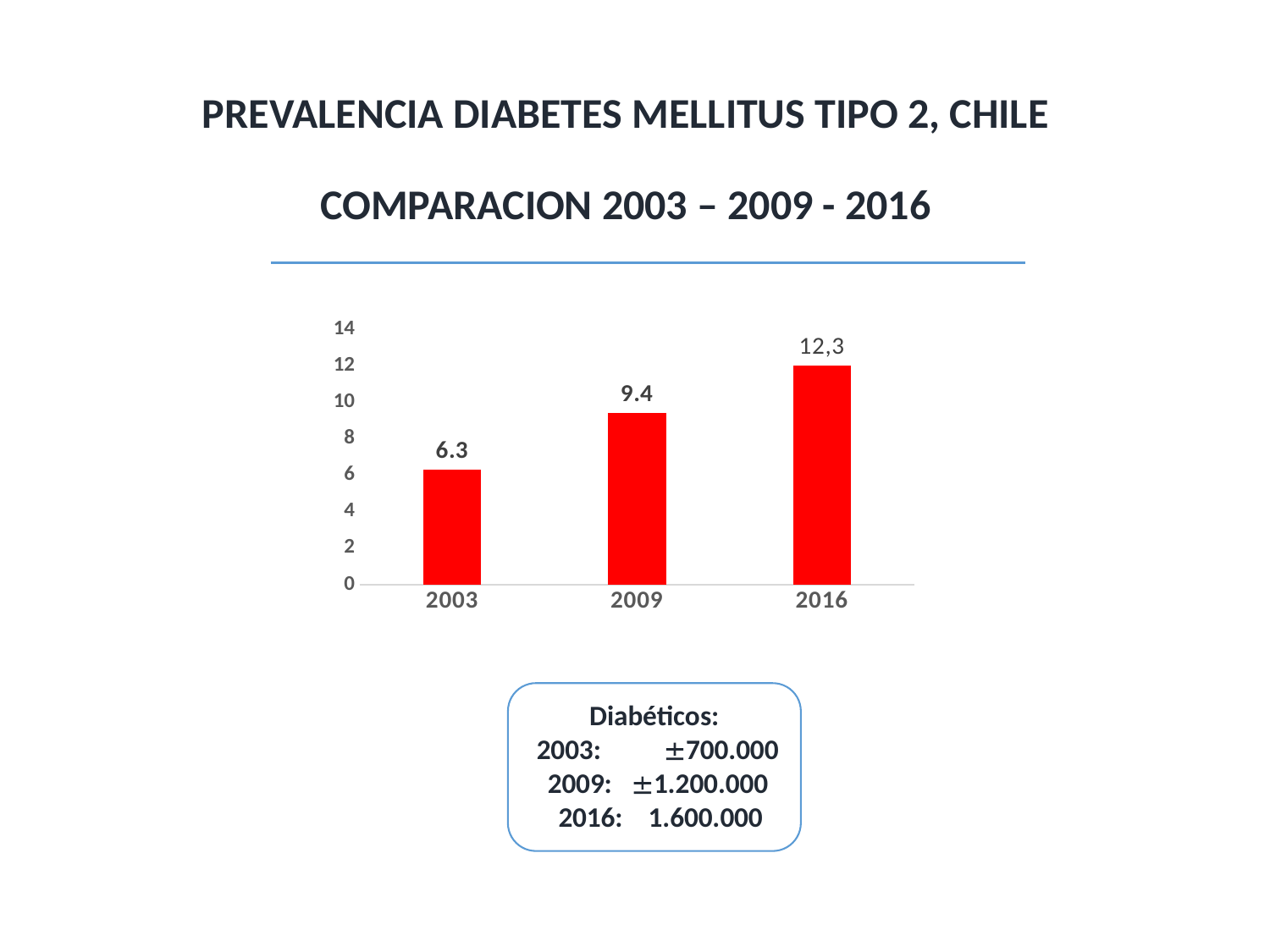
What is the value shown for 2003? 6.3 Which is larger, the value for 2009 or the value for 2016? 2016 Which year has the highest value? 2016 How many years are shown on the x axis? 3 What colour are the bars in the chart? red What kind of chart is shown on the slide? bar chart What is the value shown for 2016? 12,3 What is the difference between the values for 2009 and 2003? 3.1 Do the values rise or fall from 2003 to 2016? rise Is the value for 2003 greater or less than 8? less What is the value shown for 2009? 9.4 Which year has the lowest value? 2003